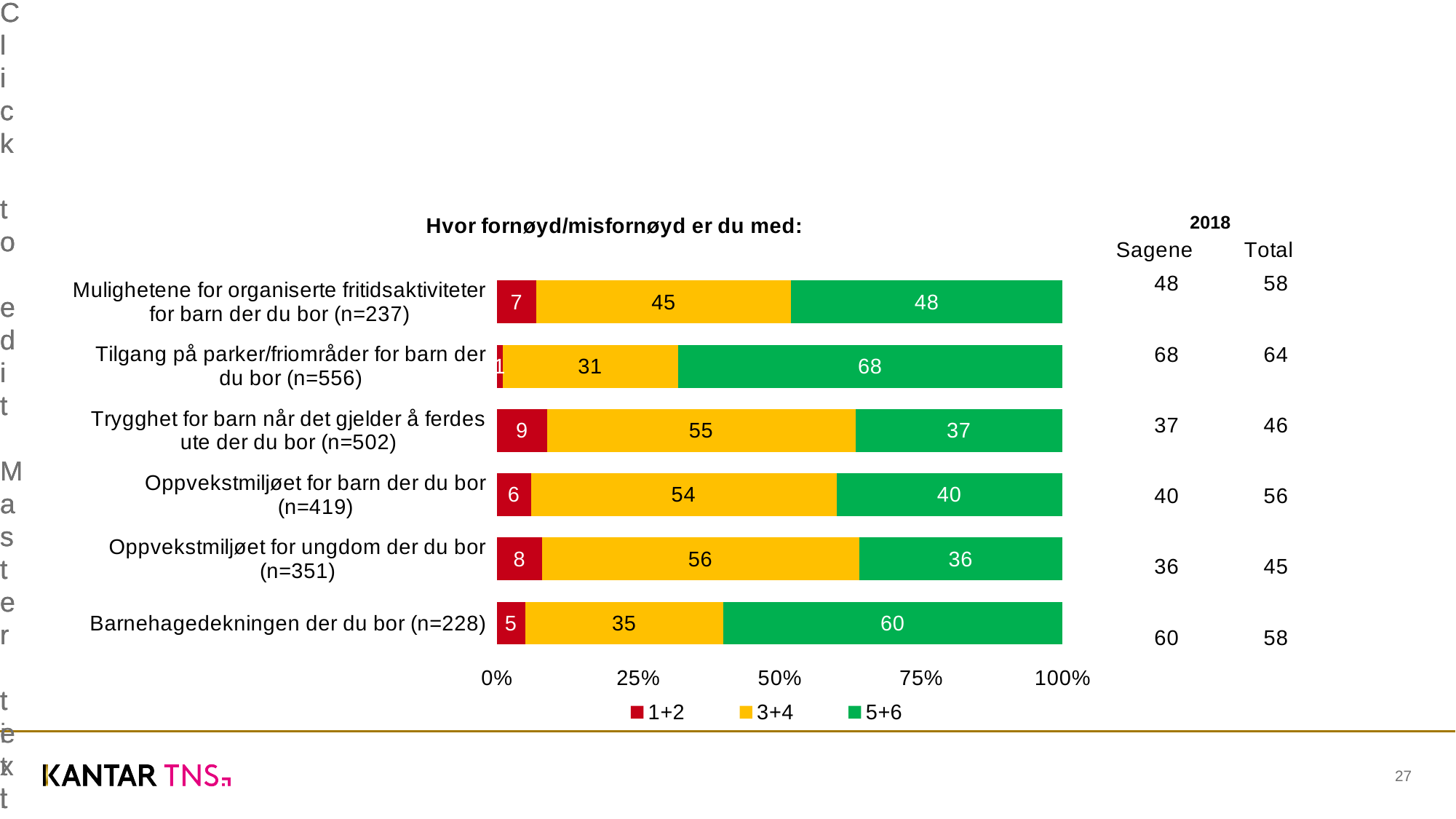
What kind of chart is shown on the slide? Stacked bar chart What is the 1+2 value for "Trygghet for barn når det gjelder å ferdes ute der du bor (n=502)"? 9 What is the difference between the 5+6 values for "Tilgang på parker/friområder for barn der du bor (n=556)" and "Oppvekstmiljøet for ungdom der du bor (n=351)"? 32 Which is larger: the 3+4 value for "Trygghet for barn når det gjelder å ferdes ute der du bor (n=502)" or the 3+4 value for "Mulighetene for organiserte fritidsaktiviteter for barn der du bor (n=237)"? Trygghet for barn når det gjelder å ferdes ute der du bor (n=502) What is the total of the stacked bar for "Oppvekstmiljøet for barn der du bor (n=419)"? 100 What is the 3+4 value for "Oppvekstmiljøet for ungdom der du bor (n=351)"? 56 What is the 5+6 value for "Barnehagedekningen der du bor (n=228)"? 60 Which category has the lowest 1+2 value? Tilgang på parker/friområder for barn der du bor (n=556) How many categories are shown in the chart? 6 Which category has the highest 5+6 value? Tilgang på parker/friområder for barn der du bor (n=556) How many series does the legend list? 3 What is the title of the chart? Hvor fornøyd/misfornøyd er du med: